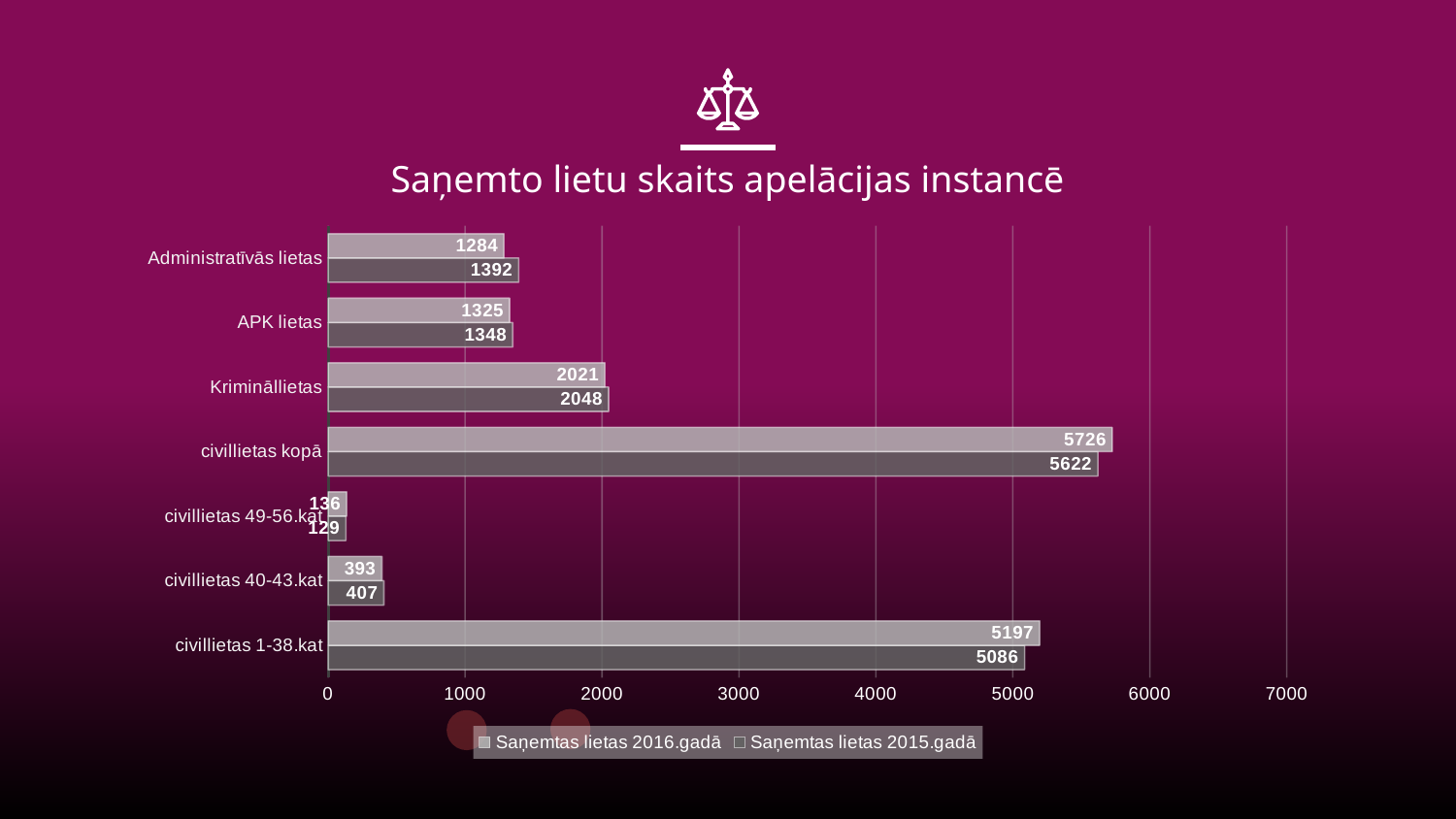
What is the title of the chart? Saņemto lietu skaits apelācijas instancē What is the value for Krimināllietas in the series Saņemtas lietas 2016.gadā? 2048 What type of chart is shown on the slide? bar chart For APK lietas, which is larger: the value for Saņemtas lietas 2016.gadā or Saņemtas lietas 2015.gadā? Saņemtas lietas 2016.gadā Is the value for civillietas 1-38.kat in the series Saņemtas lietas 2015.gadā greater or less than 5000? greater How many categories are shown on the chart? 7 How many series does the legend list? 2 What is the difference between the 2016 and 2015 values for civillietas kopā? 104 Which category has the highest value in the series Saņemtas lietas 2016.gadā? civillietas kopā Which category has the lowest value in the series Saņemtas lietas 2015.gadā? civillietas 49-56.kat What is the value for civillietas 40-43.kat in the series Saņemtas lietas 2016.gadā? 407 What is the value for Administratīvās lietas in the series Saņemtas lietas 2015.gadā? 1284